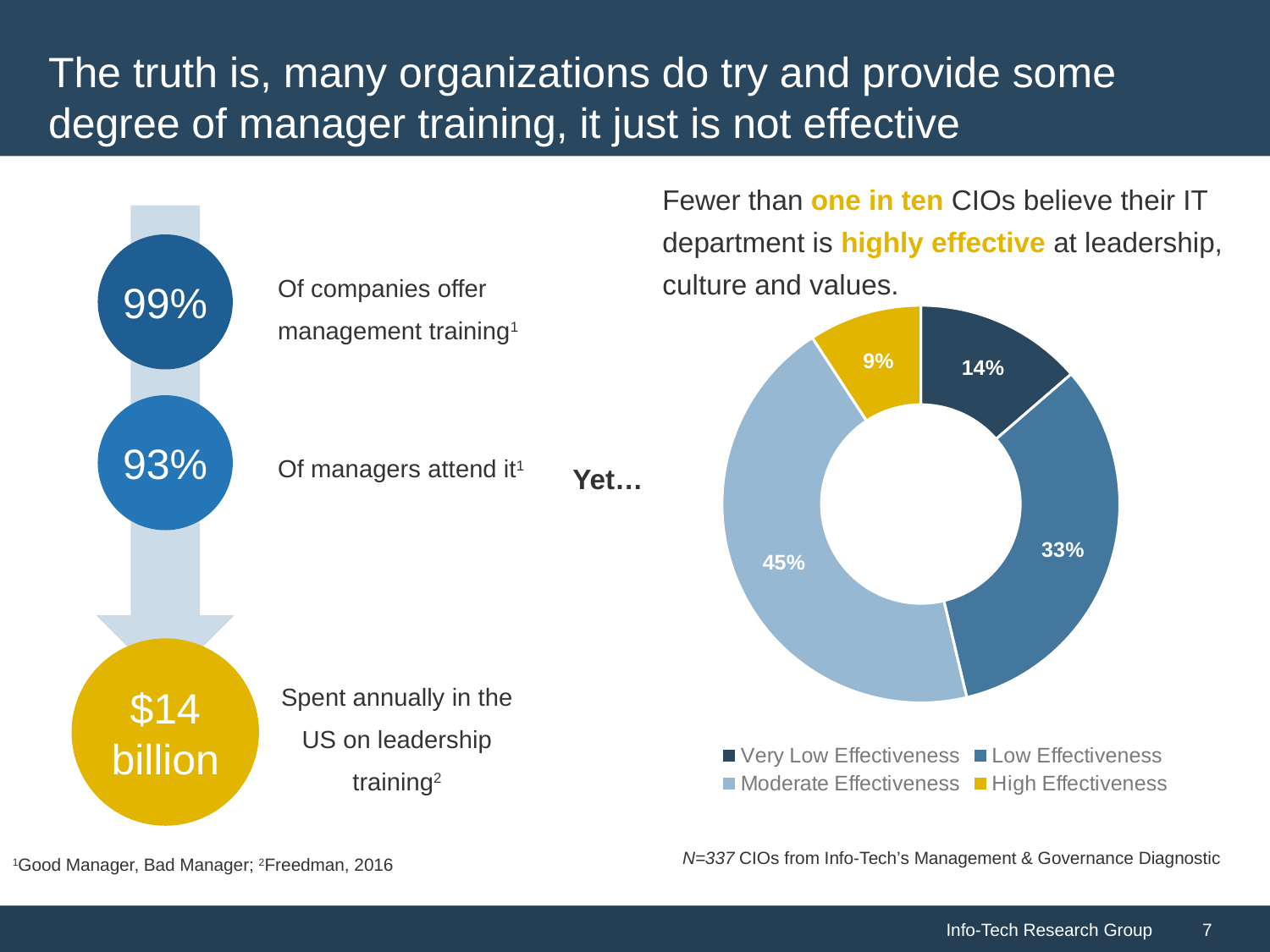
Which effectiveness category has the largest share of the chart? Moderate Effectiveness What percentage of CIOs rated their IT department as having Very Low Effectiveness? 14% What percentage of CIOs rated their IT department as having High Effectiveness? 9% What percentage of CIOs rated their IT department as having Low Effectiveness? 33% What is the combined share of Very Low Effectiveness and Low Effectiveness? 47% What kind of chart is shown on the slide? Doughnut chart Which is larger, the share for Very Low Effectiveness or the share for High Effectiveness? Very Low Effectiveness What is the difference in percentage points between Moderate Effectiveness and Low Effectiveness? 12 What colour represents High Effectiveness in the chart? Yellow What percentage of CIOs rated their IT department as having Moderate Effectiveness? 45% Which effectiveness category has the smallest share of the chart? High Effectiveness How many categories does the chart show? 4